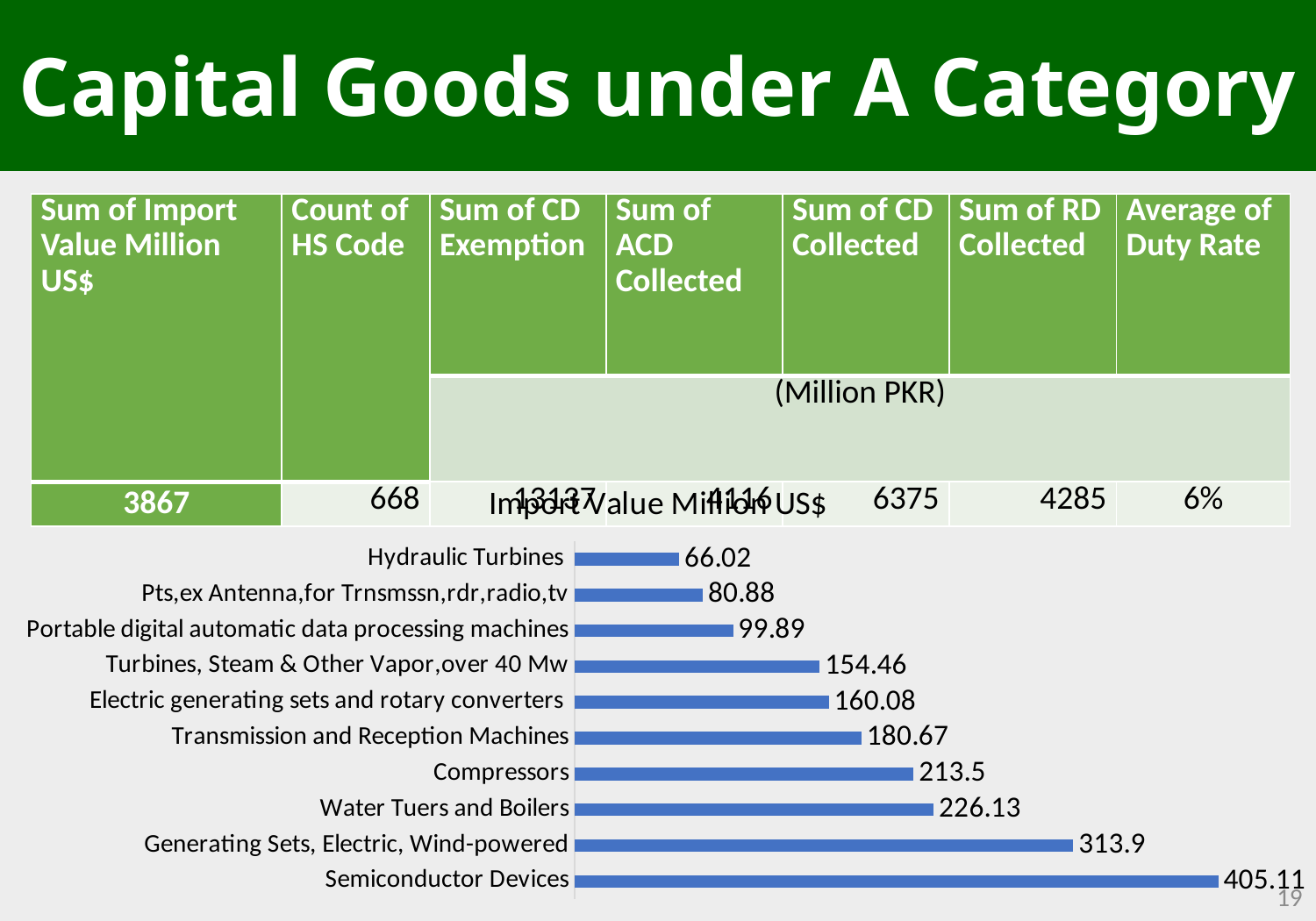
How many categories are shown in the bar chart? 10 Which category has the highest import value? Semiconductor Devices What is the title of the chart? Import Value Million US$ What is the import value for Compressors? 213.5 What is the import value for Hydraulic Turbines? 66.02 What is the import value for Semiconductor Devices? 405.11 Which category has the lowest import value? Hydraulic Turbines What is the difference between the import values of Water Tuers and Boilers and Compressors? 12.63 What type of chart is shown on the slide? Bar chart What is the import value for Transmission and Reception Machines? 180.67 What is the difference between the import values of Semiconductor Devices and Generating Sets, Electric, Wind-powered? 91.21 Which has a larger import value, Compressors or Transmission and Reception Machines? Compressors